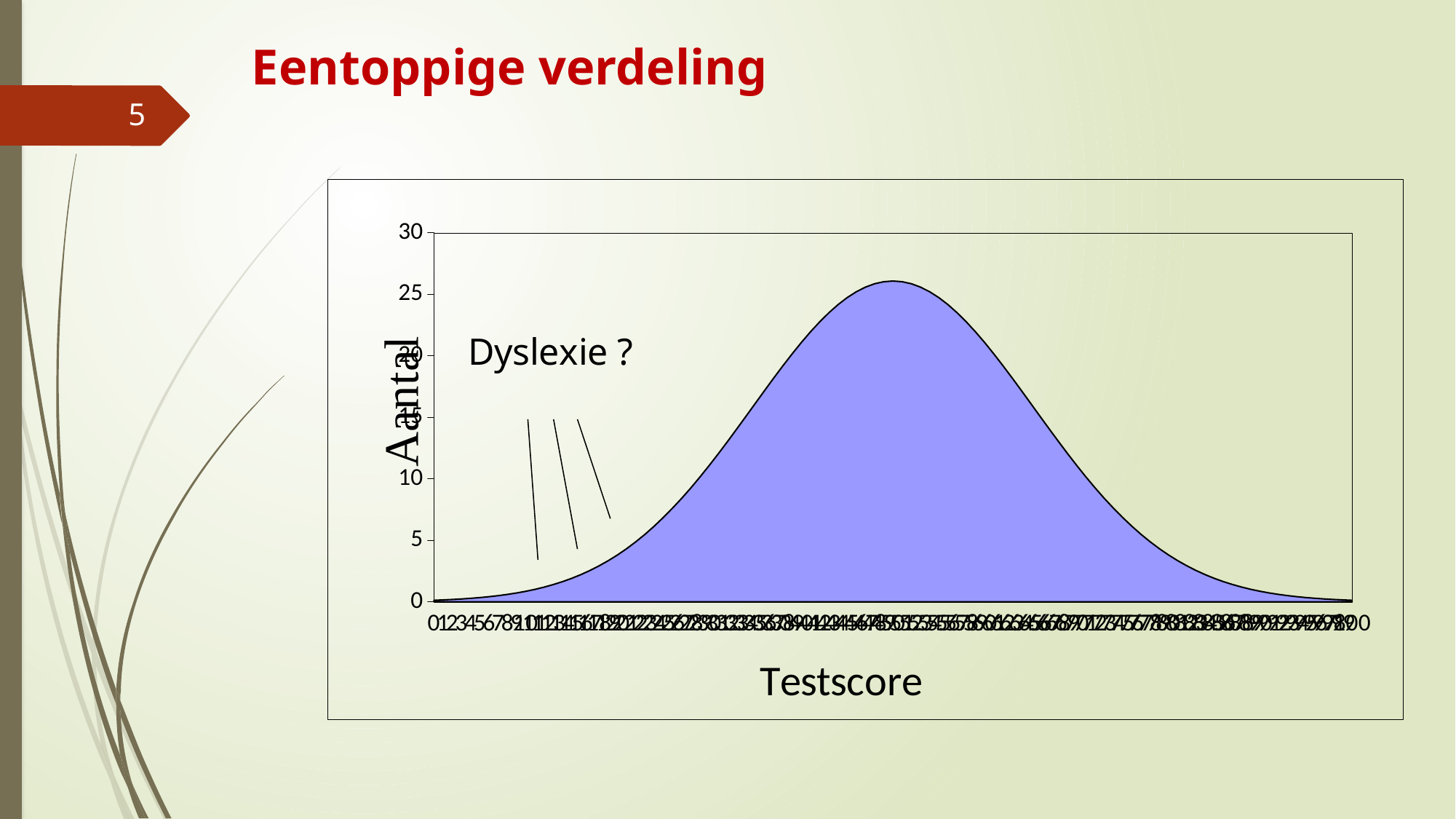
Is the value of the curve at the middle of the x axis greater or less than the value at the far left? greater What is the title of the vertical axis of the chart? Aantal Is the value of the curve at the far right of the x axis greater or less than 5? less What is the highest tick value shown on the vertical axis? 30 Is the value of the curve at the far left of the x axis greater or less than 5? less How do the values change along the x axis from left to right? rise to a single peak, then fall What is the lowest tick value shown on the vertical axis? 0 What text annotation is placed inside the chart area near the left tail of the curve? Dyslexie ? What kind of chart is shown on the slide? area chart What is the title of the horizontal axis of the chart? Testscore Is the peak value of the curve greater or less than 20? greater